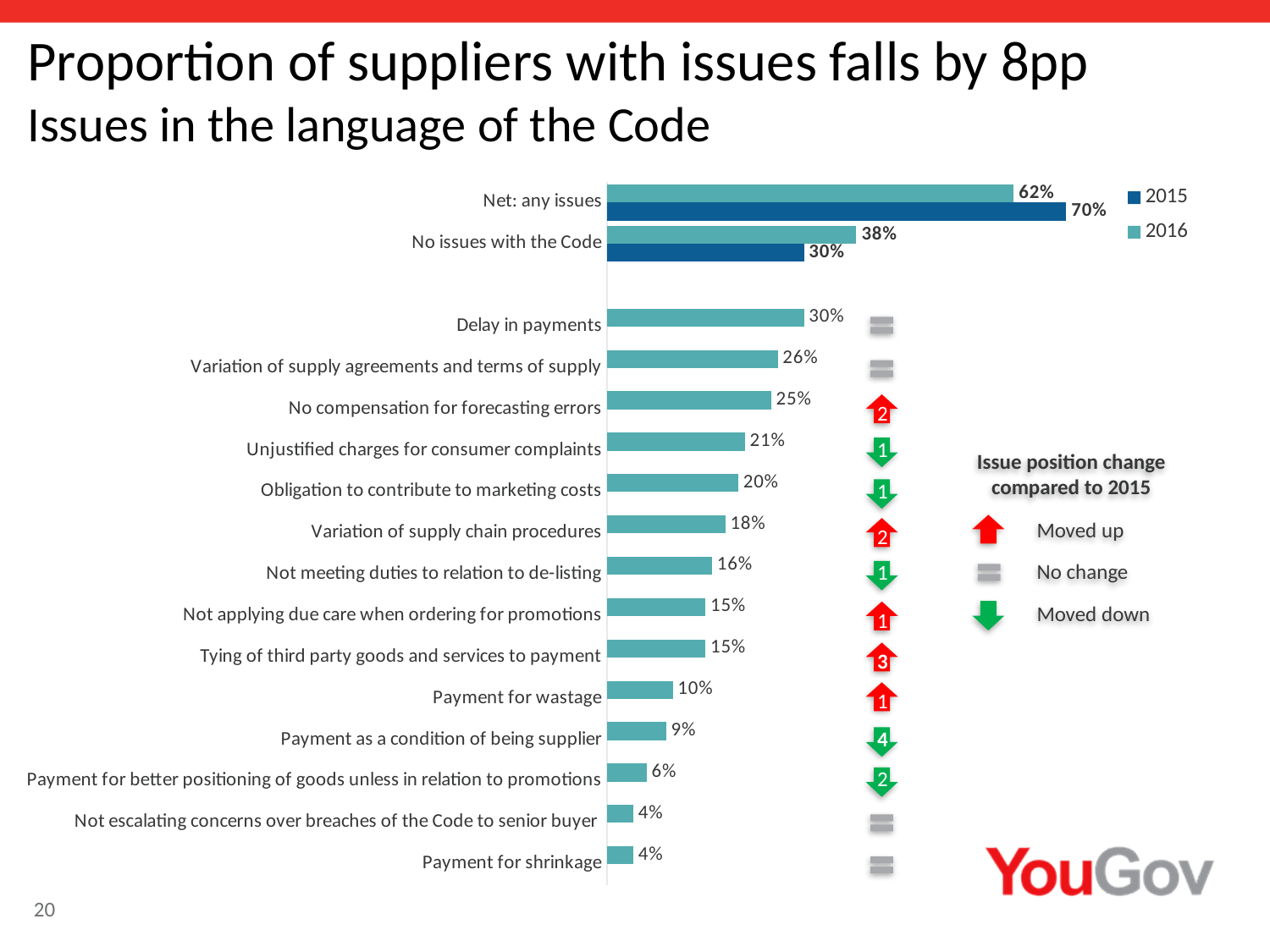
Which colour represents 2016 in the legend? Teal (light blue-green) What is the value for 'Payment for wastage'? 10% Which is larger: the value for 'Obligation to contribute to marketing costs' or 'Not meeting duties to relation to de-listing'? Obligation to contribute to marketing costs What is the difference between 'Variation of supply agreements and terms of supply' and 'Unjustified charges for consumer complaints'? 5% What is the difference between the 2015 and 2016 values for 'Net: any issues'? 8pp What kind of chart is shown on the slide? Bar chart How many categories are plotted on the chart? 16 What is the 2016 value for 'Net: any issues'? 62% What is the value for 'Delay in payments'? 30% Which of the individual issues listed below 'No issues with the Code' has the highest value? Delay in payments What is the 2015 value for 'No issues with the Code'? 30% How many series does the legend list? 2